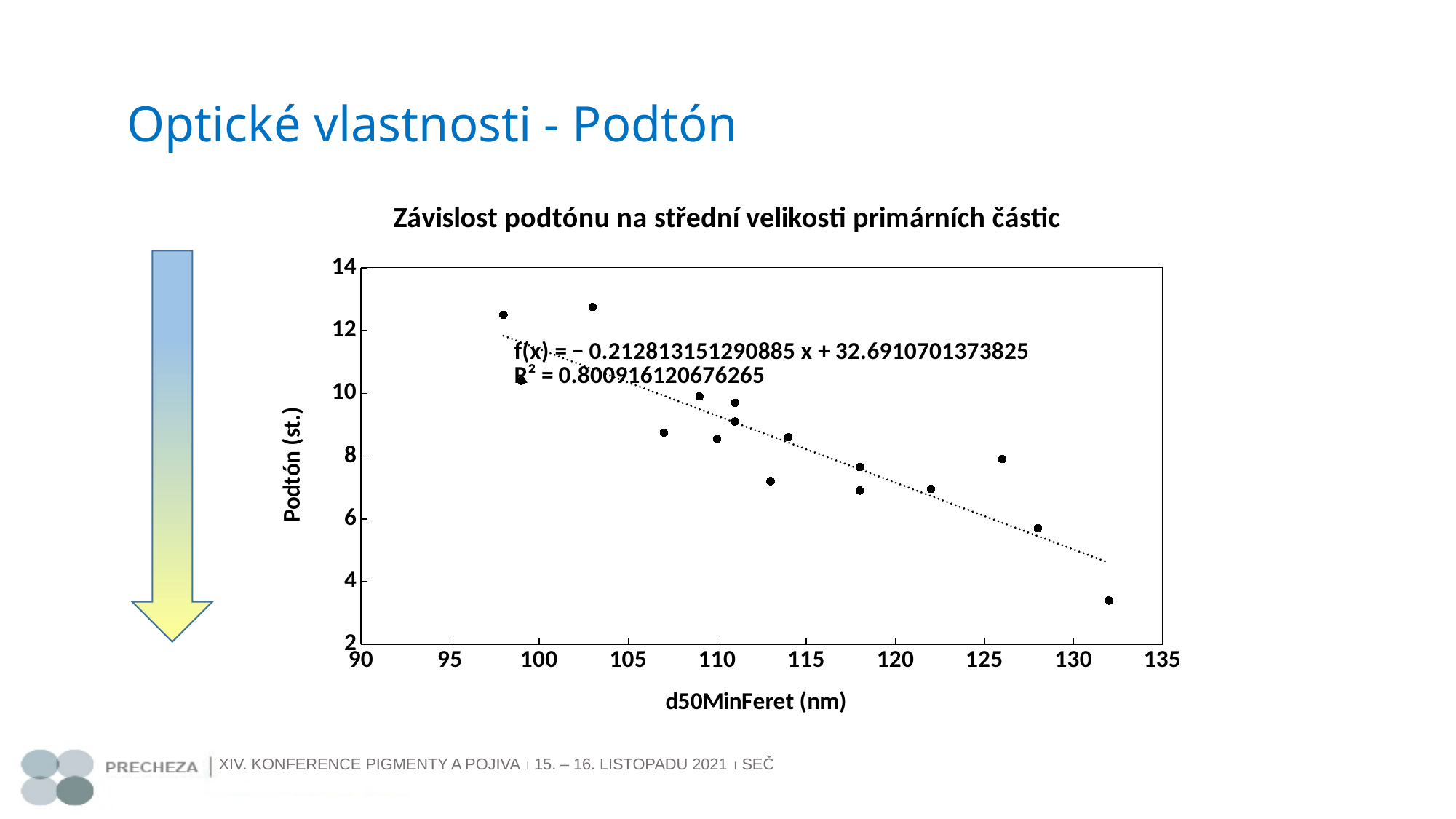
Do the Podtón values generally rise or fall as d50MinFeret increases along the x axis? fall Is the Podtón value for the point at d50MinFeret 132 nm greater or less than 4? less What is the maximum value shown on the y axis? 14 What is the label of the x axis? d50MinFeret (nm) What kind of chart is shown on the slide? scatter chart What is the slope of the trendline equation printed on the chart? −0.212813151290885 Which point has the lowest Podtón value, the one at 132 nm or the one at 98 nm? 132 nm What is the R² value printed on the chart? 0.800916120676265 Is the Podtón value for the point at d50MinFeret 128 nm greater or less than 6? less What is the title of the chart? Závislost podtónu na střední velikosti primárních částic Is the Podtón value for the point at d50MinFeret 103 nm greater or less than 12? greater What is the intercept of the trendline equation printed on the chart? 32.6910701373825